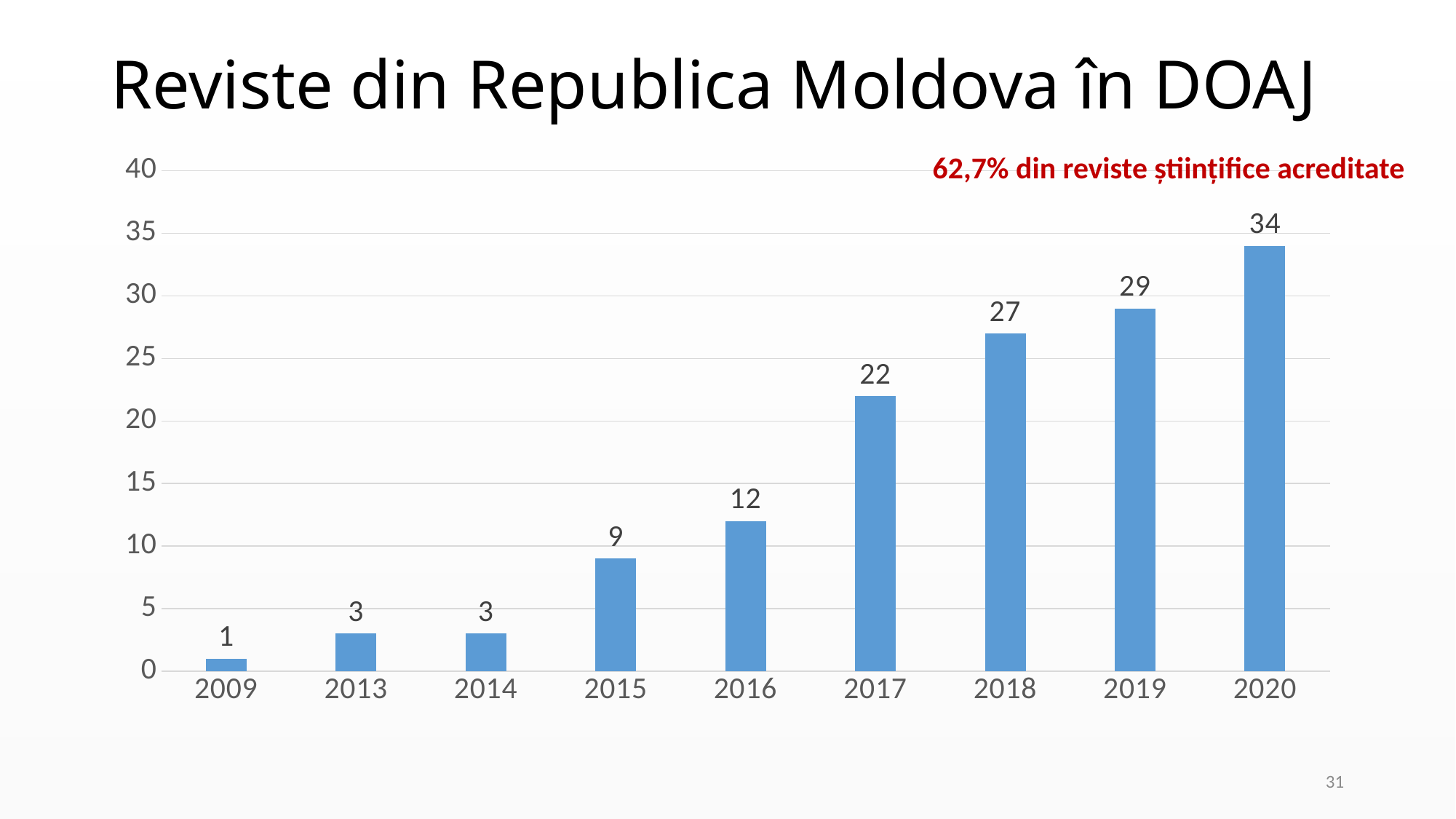
What is the value for 2015? 9 Which year has the lowest value? 2009 What is the value for 2009? 1 Which is larger, the value for 2016 or the value for 2015? 2016 What is the difference between the values for 2018 and 2016? 15 What is the difference between the values for 2020 and 2019? 5 Is the value for 2018 greater or less than 25? greater Do the values generally rise or fall from 2009 to 2020? rise How many years are shown on the x axis? 9 Which year has the highest value? 2020 What kind of chart is shown on the slide? bar chart What is the value for 2017? 22